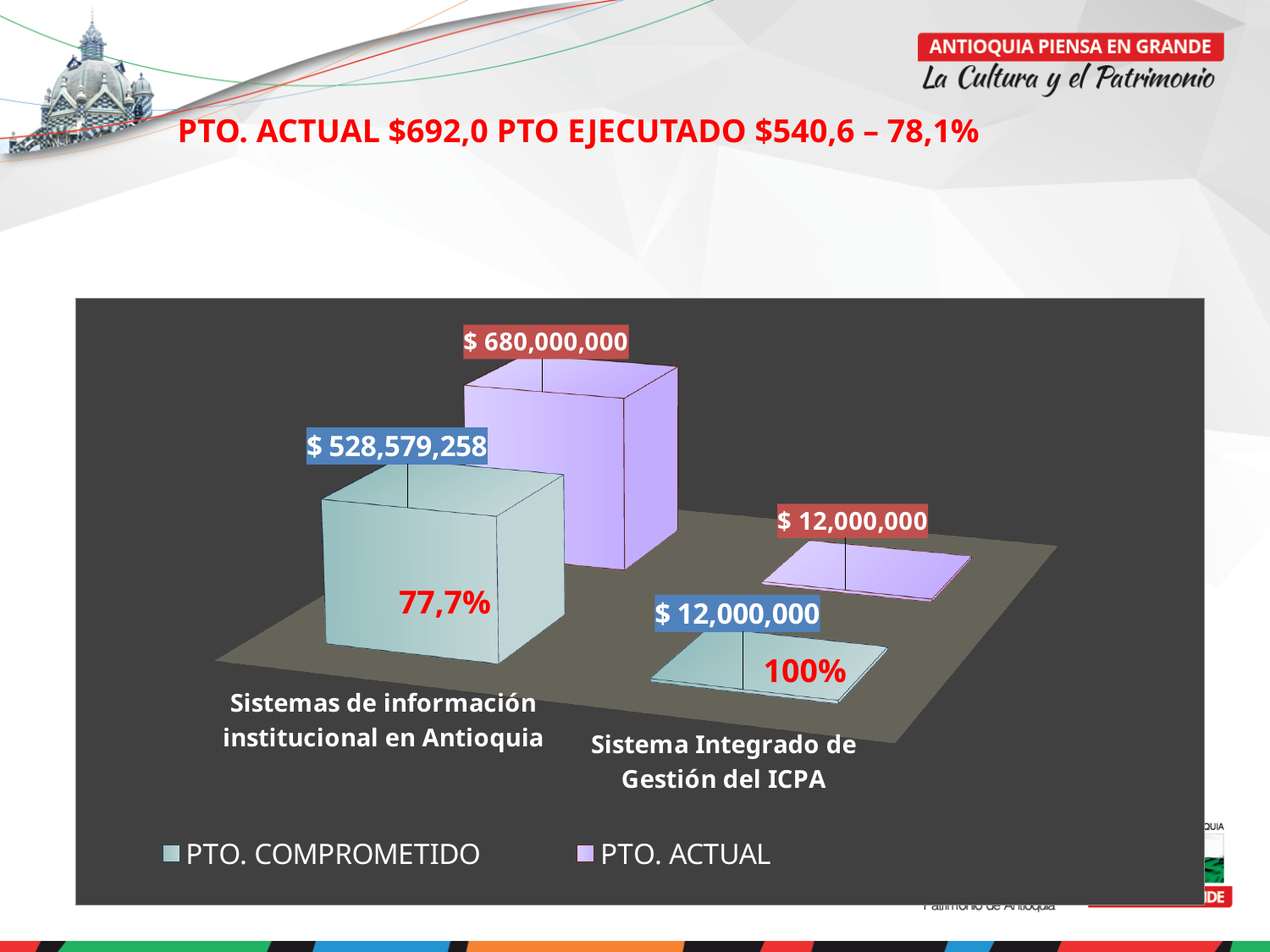
What is the PTO. ACTUAL value for Sistema Integrado de Gestión del ICPA? $ 12,000,000 What is the PTO. ACTUAL value for Sistemas de información institucional en Antioquia? $ 680,000,000 What is the PTO. COMPROMETIDO value for Sistema Integrado de Gestión del ICPA? $ 12,000,000 Which category has the lowest PTO. COMPROMETIDO value? Sistema Integrado de Gestión del ICPA Which category has the highest PTO. ACTUAL value? Sistemas de información institucional en Antioquia What is the difference between PTO. ACTUAL and PTO. COMPROMETIDO for Sistemas de información institucional en Antioquia? $ 151,420,742 How many series does the legend list? 2 For Sistemas de información institucional en Antioquia, which is larger: PTO. ACTUAL or PTO. COMPROMETIDO? PTO. ACTUAL What percentage is shown next to the PTO. COMPROMETIDO bar for Sistemas de información institucional en Antioquia? 77,7% What is the PTO. COMPROMETIDO value for Sistemas de información institucional en Antioquia? $ 528,579,258 How many categories are shown on the chart? 2 What kind of chart is shown on the slide? Bar chart